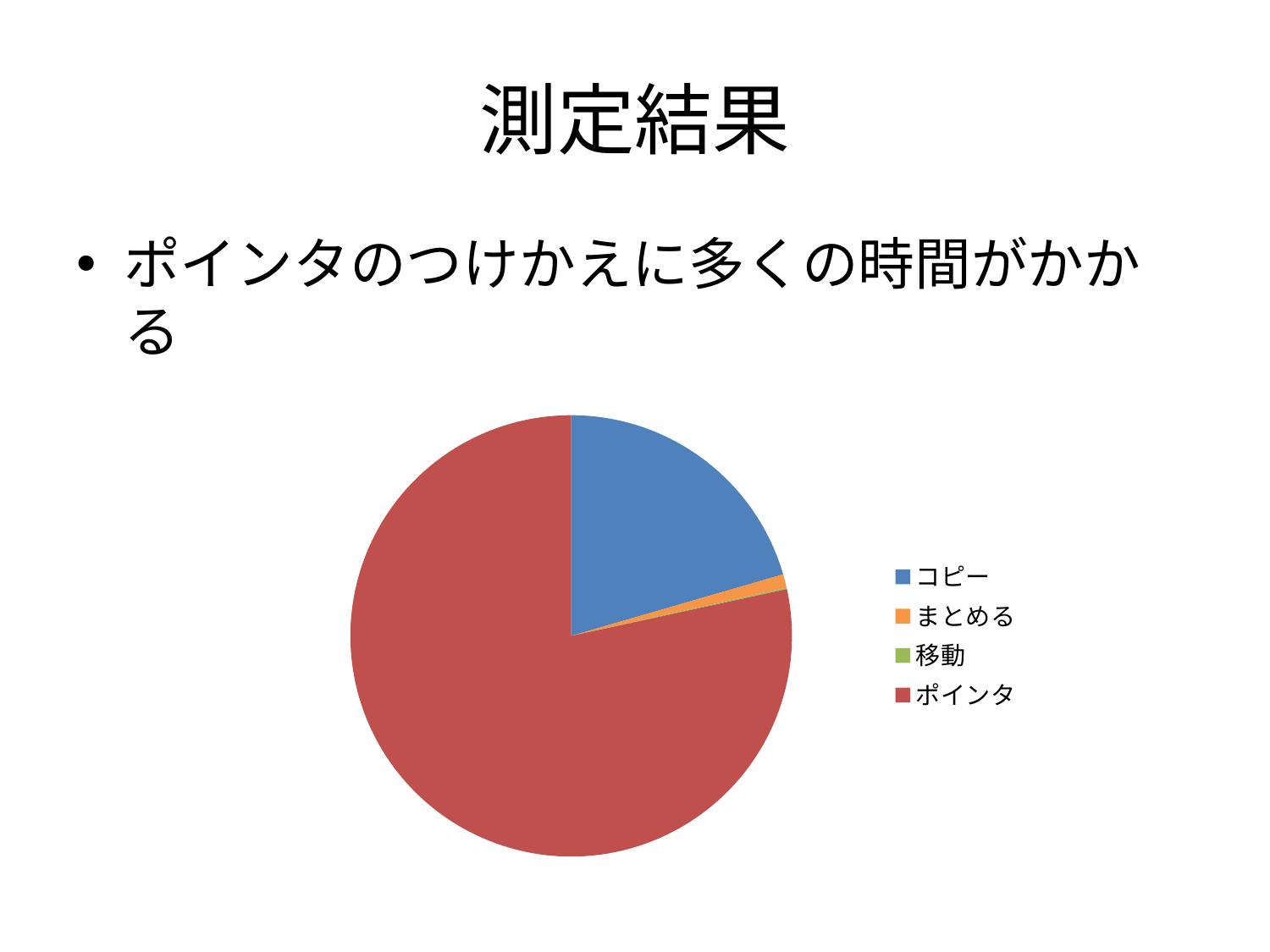
How many entries does the legend of the pie chart list? 4 How many categories does the pie chart have? 4 Which is larger in the pie chart, the slice for コピー or the slice for まとめる? コピー Which category has the largest slice in the pie chart? ポインタ What colour is the slice for コピー in the pie chart? blue What is the title of the slide containing the pie chart? 測定結果 Which is larger in the pie chart, the slice for コピー or the slice for 移動? コピー Which is larger in the pie chart, the slice for ポインタ or the slice for コピー? ポインタ Does the slice for ポインタ take up more or less than half of the pie chart? more What kind of chart is shown on the slide? pie chart